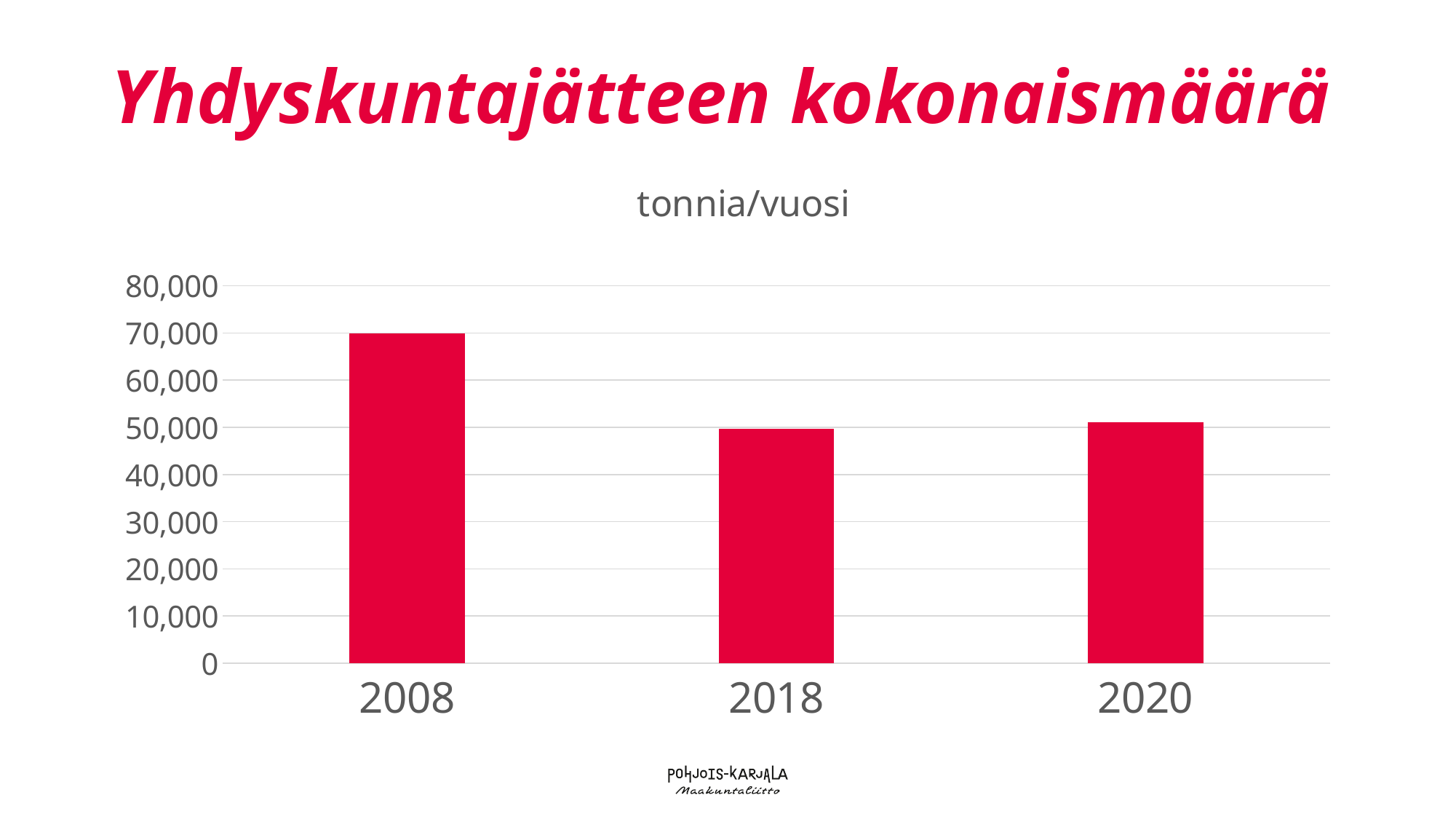
Which year has the highest value in the chart? 2008 What is the title shown above the chart's plot area? tonnia/vuosi Is the value for 2018 greater or less than 60,000? less Which is larger, the value for 2008 or the value for 2020? 2008 Does the value fall or rise from 2008 to 2018? fall Is the value for 2020 greater or less than 40,000? greater How many bars (years) are plotted in the chart? 3 Which is larger, the value for 2008 or the value for 2018? 2008 Is the value for 2008 greater or less than 60,000? greater What is the highest value shown on the vertical axis? 80,000 What kind of chart is shown on the slide? bar chart